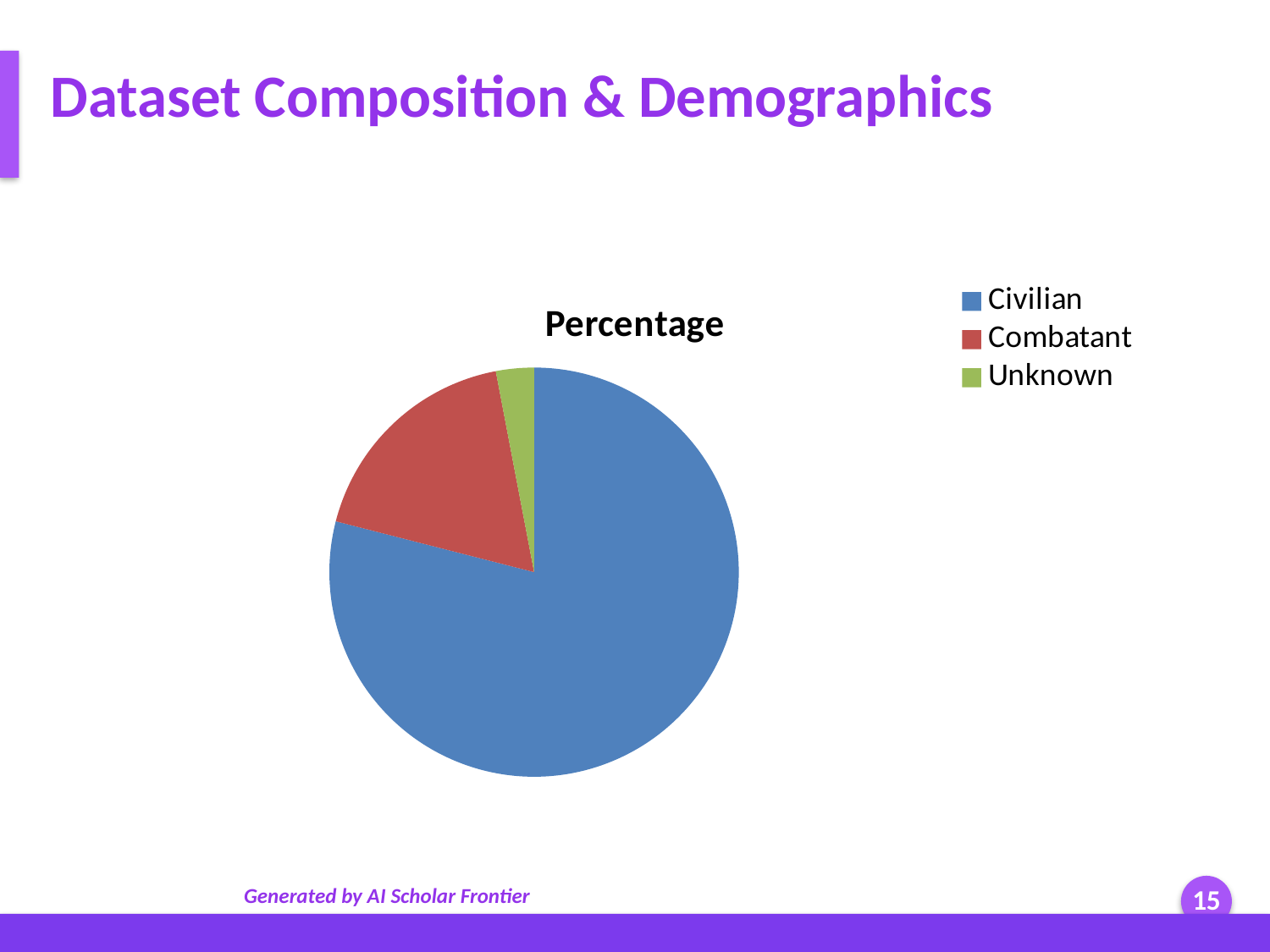
Which category has the smallest slice of the pie? Unknown How many categories does the legend list? 3 Which slice is larger, Combatant or Unknown? Combatant Does the Civilian slice take up more or less than half of the pie? more What kind of chart is shown on the slide? pie chart Which colour represents the Civilian category? blue Which category has the largest slice of the pie? Civilian What is the title of the chart? Percentage Which slice is larger, Civilian or Combatant? Civilian